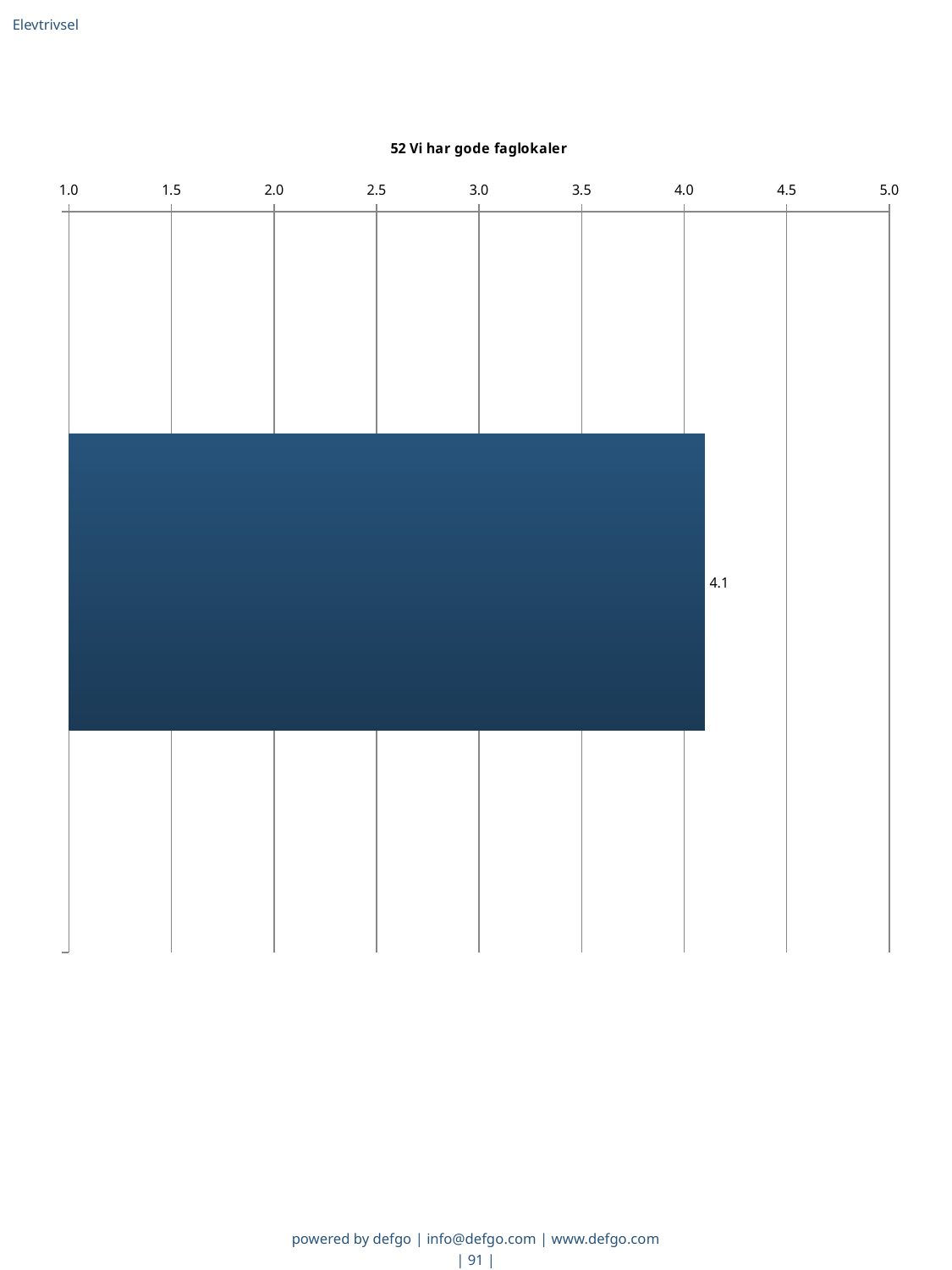
How many bars are plotted in the chart? 1 What is the minimum value shown on the chart's axis? 1.0 What is the value shown by the bar in the chart '52 Vi har gode faglokaler'? 4.1 What is the title of the chart? 52 Vi har gode faglokaler Is the value of the bar greater or less than 4.5? less Is the value of the bar greater or less than 4.0? greater What kind of chart is shown on the slide? bar chart What is the maximum value shown on the chart's axis? 5.0